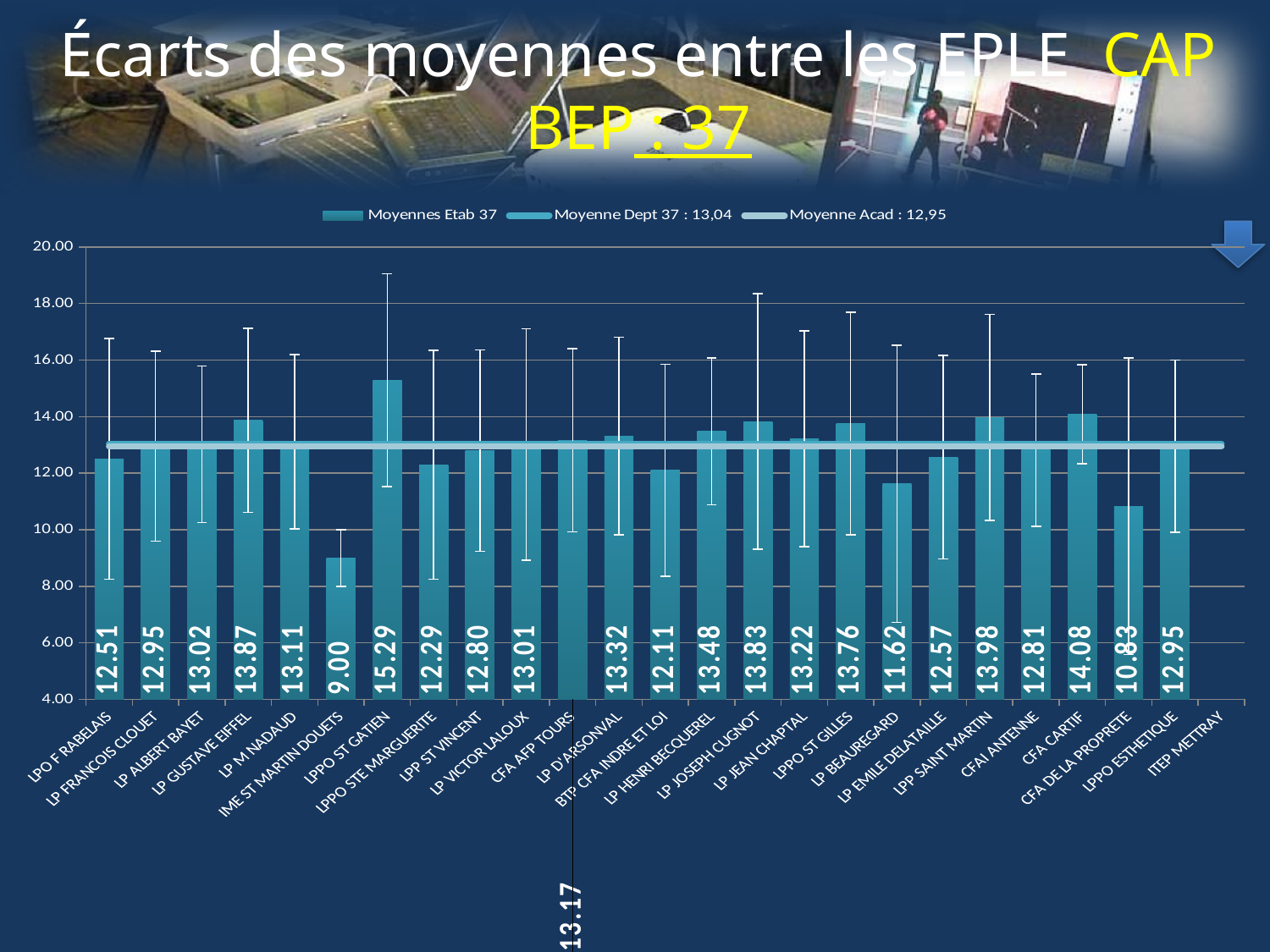
Which establishment has the lowest value? IME ST MARTIN DOUETS According to the legend, what is the value of Moyenne Dept 37? 13,04 Is the value for LPPO ST GATIEN greater or less than 14.00? greater Which is larger, the value for LP GUSTAVE EIFFEL or the value for CFA DE LA PROPRETE? LP GUSTAVE EIFFEL What is the value for IME ST MARTIN DOUETS? 9.00 What is the value for LPPO ST GATIEN? 15.29 How many series does the legend list? 3 What is the value for CFA CARTIF? 14.08 What kind of chart is shown on the slide? bar chart Which establishment has the highest value? LPPO ST GATIEN What is the value for LP BEAUREGARD? 11.62 What is the difference between the values for LPPO ST GATIEN and IME ST MARTIN DOUETS? 6.29